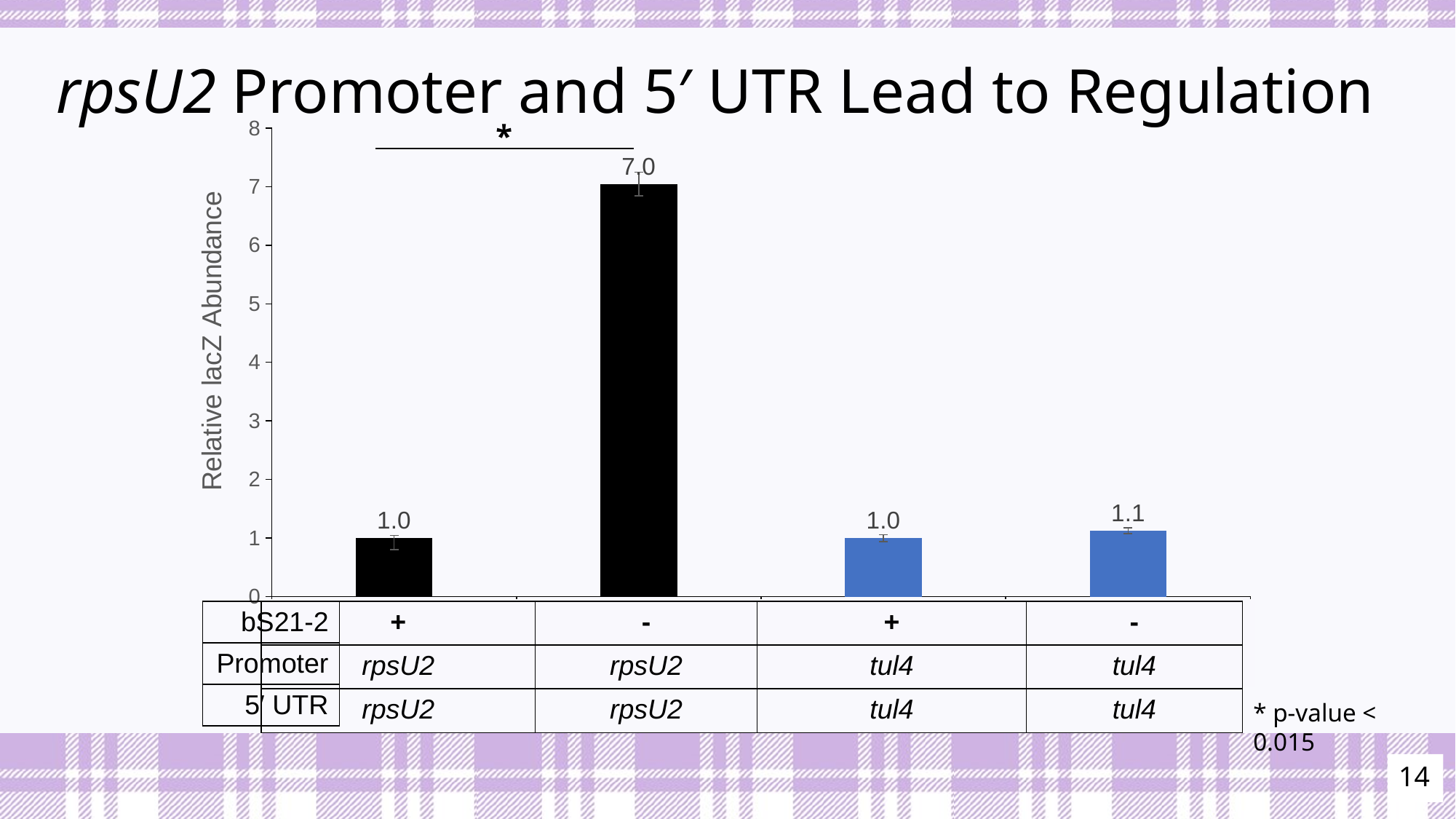
What is the relative lacZ abundance for the rpsU2 promoter and 5′ UTR construct without bS21-2 (-)? 7.0 Which construct has the highest relative lacZ abundance? rpsU2 promoter and 5′ UTR without bS21-2 (-) What kind of chart is shown on the slide? Bar chart What colour are the bars for the tul4 promoter and 5′ UTR constructs? Blue What is the difference in relative lacZ abundance between the rpsU2 construct without bS21-2 (-) and the rpsU2 construct with bS21-2 (+)? 6.0 What is the label of the y-axis? Relative lacZ Abundance How many bars are plotted in the chart? 4 What is the relative lacZ abundance for the tul4 promoter and 5′ UTR construct with bS21-2 present (+)? 1.0 What is the relative lacZ abundance for the tul4 promoter and 5′ UTR construct without bS21-2 (-)? 1.1 Which is larger: the relative lacZ abundance for the rpsU2 construct without bS21-2 (-) or for the tul4 construct without bS21-2 (-)? rpsU2 construct without bS21-2 (-) Is the relative lacZ abundance for the rpsU2 construct without bS21-2 (-) greater or less than 6? greater What is the relative lacZ abundance for the rpsU2 promoter and 5′ UTR construct with bS21-2 present (+)? 1.0